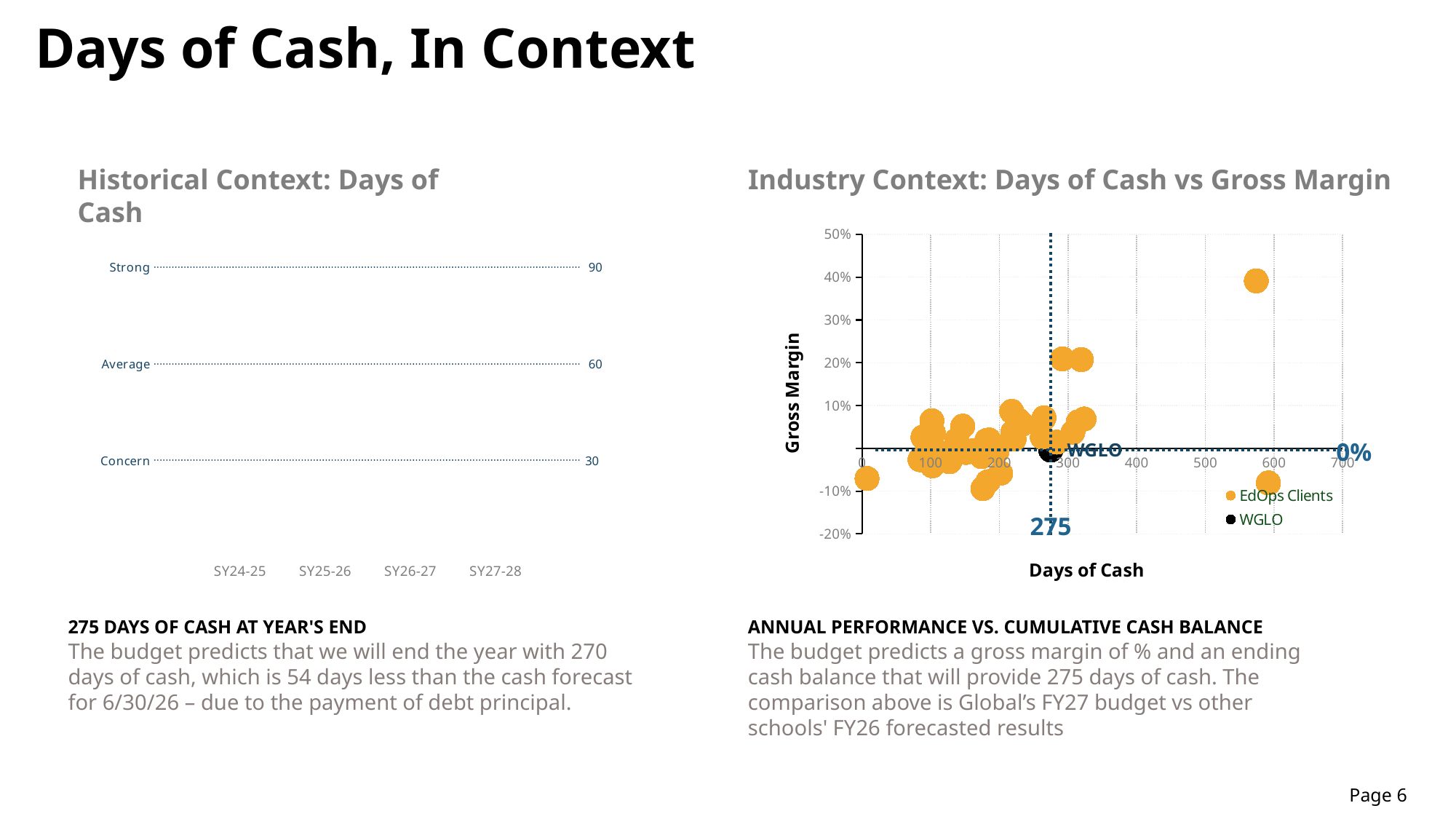
On the 'Industry Context: Days of Cash vs Gross Margin' chart, is the gross margin of the highest EdOps client point greater or less than 30%? greater On the 'Industry Context: Days of Cash vs Gross Margin' chart, what gross margin is labelled for WGLO? 0% On the 'Industry Context: Days of Cash vs Gross Margin' chart, is the days of cash of the EdOps client point furthest to the right greater or less than 500? greater On the 'Historical Context: Days of Cash' chart, what value is shown for the 'Average' reference line? 60 How many series does the legend of the 'Industry Context: Days of Cash vs Gross Margin' chart list? 2 What are the two legend entries on the 'Industry Context: Days of Cash vs Gross Margin' chart? EdOps Clients and WGLO On the 'Historical Context: Days of Cash' chart, what value is shown for the 'Strong' reference line? 90 On the 'Historical Context: Days of Cash' chart, what value is shown for the 'Concern' reference line? 30 How many school years are listed along the x axis of the 'Historical Context: Days of Cash' chart? 4 What is the title of the vertical axis on the 'Industry Context: Days of Cash vs Gross Margin' chart? Gross Margin On the 'Industry Context: Days of Cash vs Gross Margin' chart, what is the days of cash value labelled for WGLO? 275 What kind of chart is the 'Industry Context: Days of Cash vs Gross Margin' chart? scatter chart